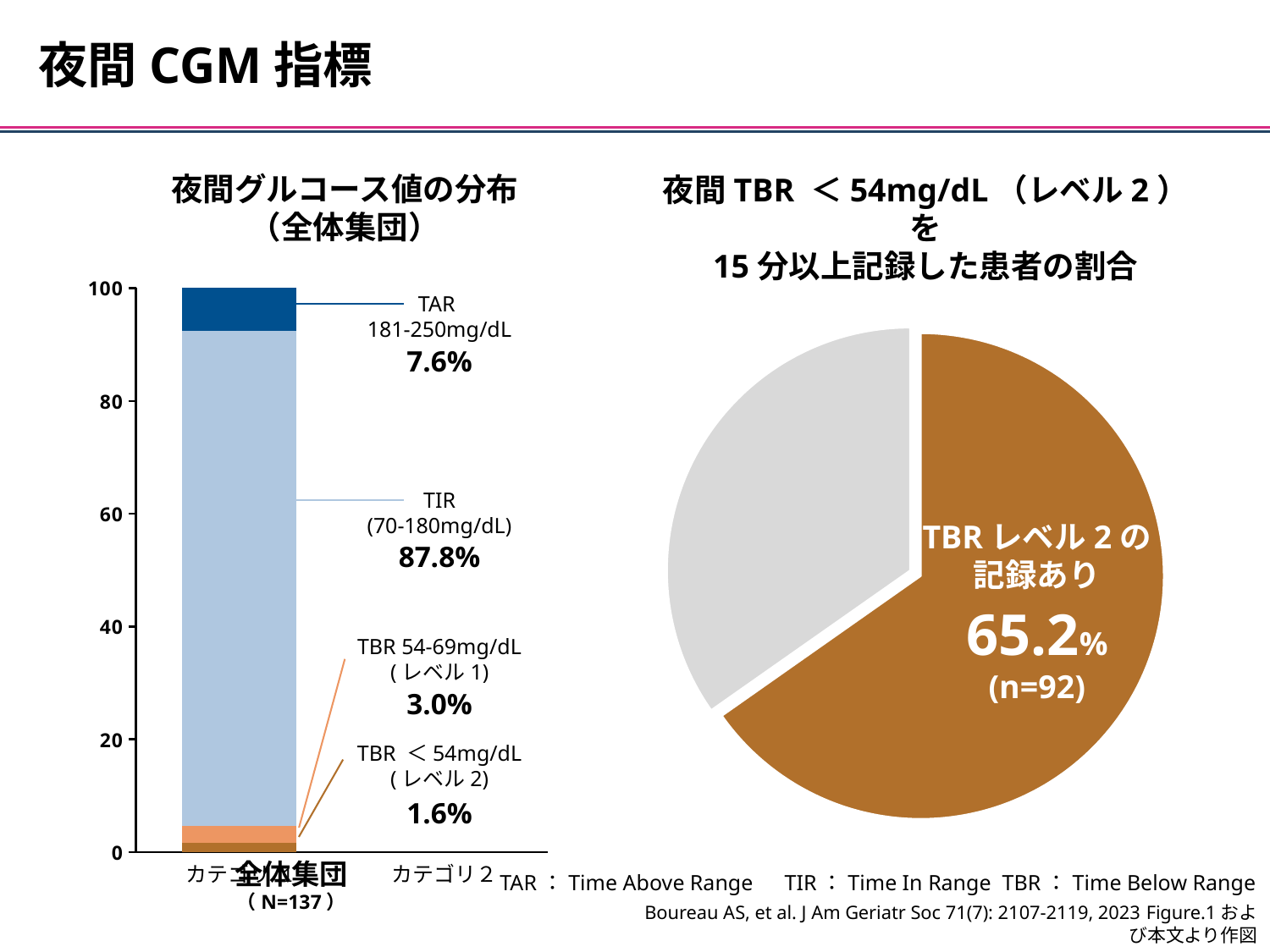
What kind of chart is the left chart (夜間グルコース値の分布)? Stacked bar chart In the left chart (夜間グルコース値の分布), how many segments make up the stacked bar? 4 In the left chart (夜間グルコース値の分布), what is the value for TAR 181-250mg/dL? 7.6% What kind of chart is the right chart (夜間 TBR ＜54mg/dL（レベル 2）を 15 分以上記録した患者の割合)? Pie chart In the left chart (夜間グルコース値の分布), what is the value for TIR (70-180mg/dL)? 87.8% In the left chart (夜間グルコース値の分布), which segment of the stacked bar has the largest value? TIR (70-180mg/dL) In the left chart (夜間グルコース値の分布), what is the value for TBR ＜54mg/dL (レベル 2)? 1.6% In the left chart (夜間グルコース値の分布), what is the value for TBR 54-69mg/dL (レベル 1)? 3.0% In the left chart (夜間グルコース値の分布), which is larger: TAR 181-250mg/dL or TBR 54-69mg/dL (レベル 1)? TAR 181-250mg/dL In the right pie chart, what share of patients had a TBR レベル 2 record (TBR レベル 2 の記録あり)? 65.2% In the left chart (夜間グルコース値の分布), which segment of the stacked bar has the smallest value? TBR ＜54mg/dL (レベル 2) In the left chart (夜間グルコース値の分布), what is the difference between the TAR 181-250mg/dL value and the TBR 54-69mg/dL (レベル 1) value? 4.6%